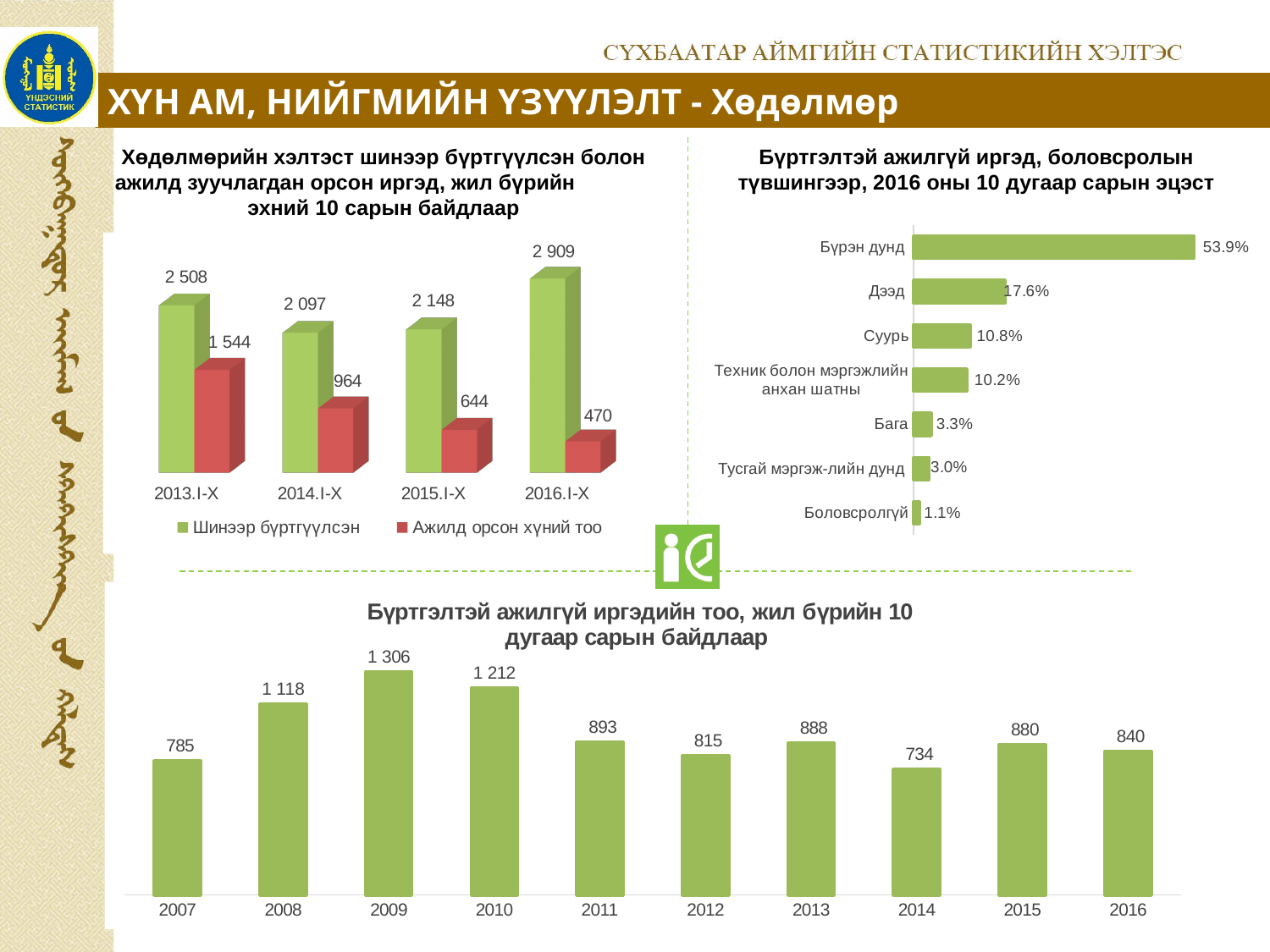
In the bottom chart (Бүртгэлтэй ажилгүй иргэдийн тоо), what is the value for 2009? 1 306 In the top-right chart, which education level has the highest share? Бүрэн дунд In the top-right chart, what kind of chart is it? Bar chart In the top-left chart, in which period is Ажилд орсон хүний тоо lowest? 2016.I-X In the top-right chart (Бүртгэлтэй ажилгүй иргэд, боловсролын түвшингээр), what is the share for Дээд? 17.6% In the top-left chart (Хөдөлмөрийн хэлтэст шинээр бүртгүүлсэн болон ажилд зуучлагдан орсон иргэд), what is the value for Шинээр бүртгүүлсэн in 2016.I-X? 2 909 In the top-left chart, how many series does the legend list? 2 In the top-left chart, what is the value for Ажилд орсон хүний тоо in 2013.I-X? 1 544 In the bottom chart, which year has the lowest value? 2014 In the top-right chart, how many categories are shown? 7 In the top-left chart, what is the difference between Шинээр бүртгүүлсэн and Ажилд орсон хүний тоо in 2015.I-X? 1 504 In the bottom chart, what is the difference between the values for 2010 and 2011? 319